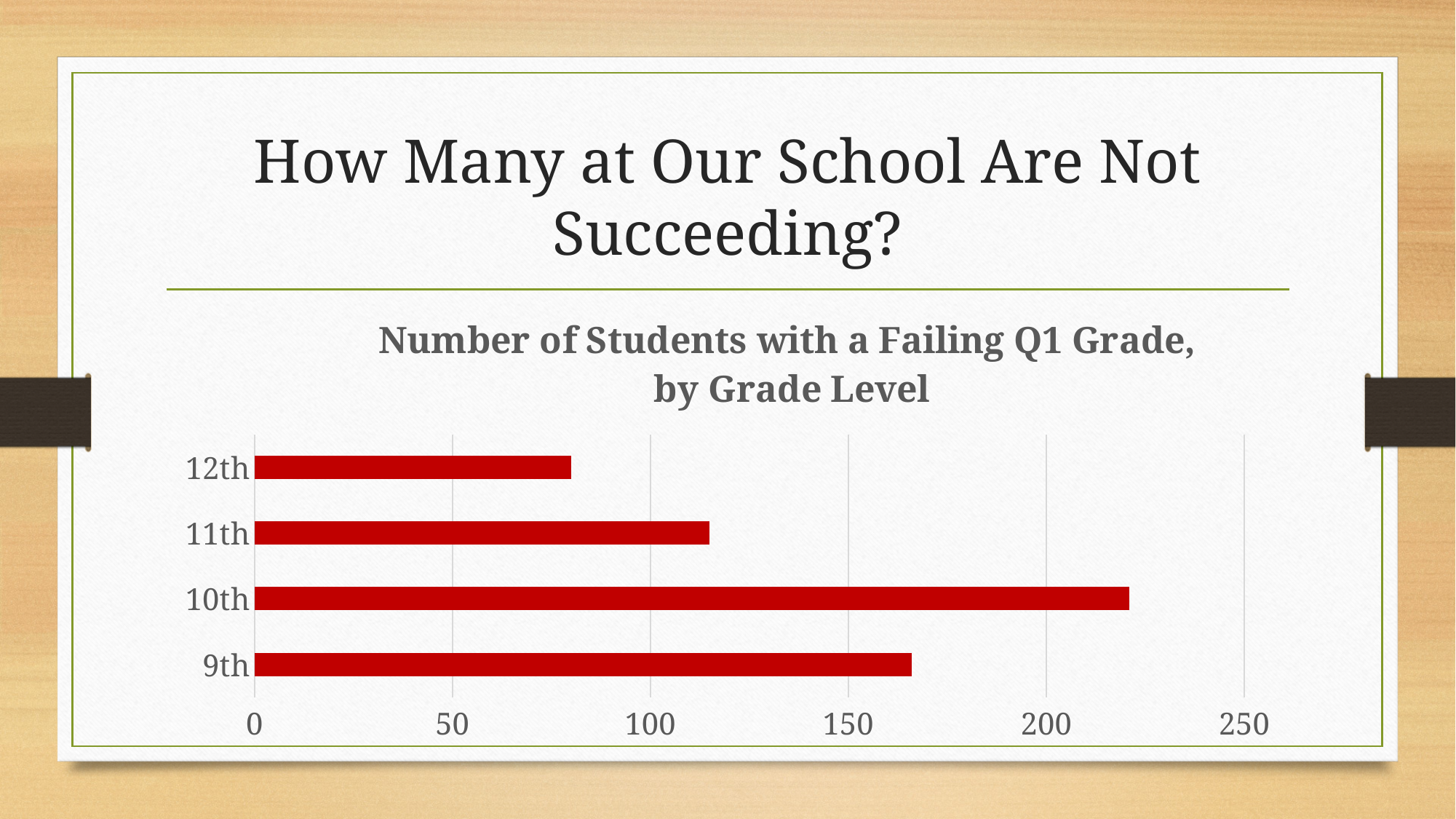
How many grade levels are shown in the chart? 4 Is the value for 9th grade greater or less than 150? greater Which grade level has the lowest number of students with a failing Q1 grade? 12th Which grade level has the highest number of students with a failing Q1 grade? 10th Is the value for 10th grade greater or less than 200? greater What is the title of the chart? Number of Students with a Failing Q1 Grade, by Grade Level What kind of chart is shown on the slide? bar chart Which grade level has more students with a failing Q1 grade, 9th or 11th? 9th What colour are the bars in the chart? red Is the value for 11th grade greater or less than 100? greater Which grade level has more students with a failing Q1 grade, 11th or 12th? 11th